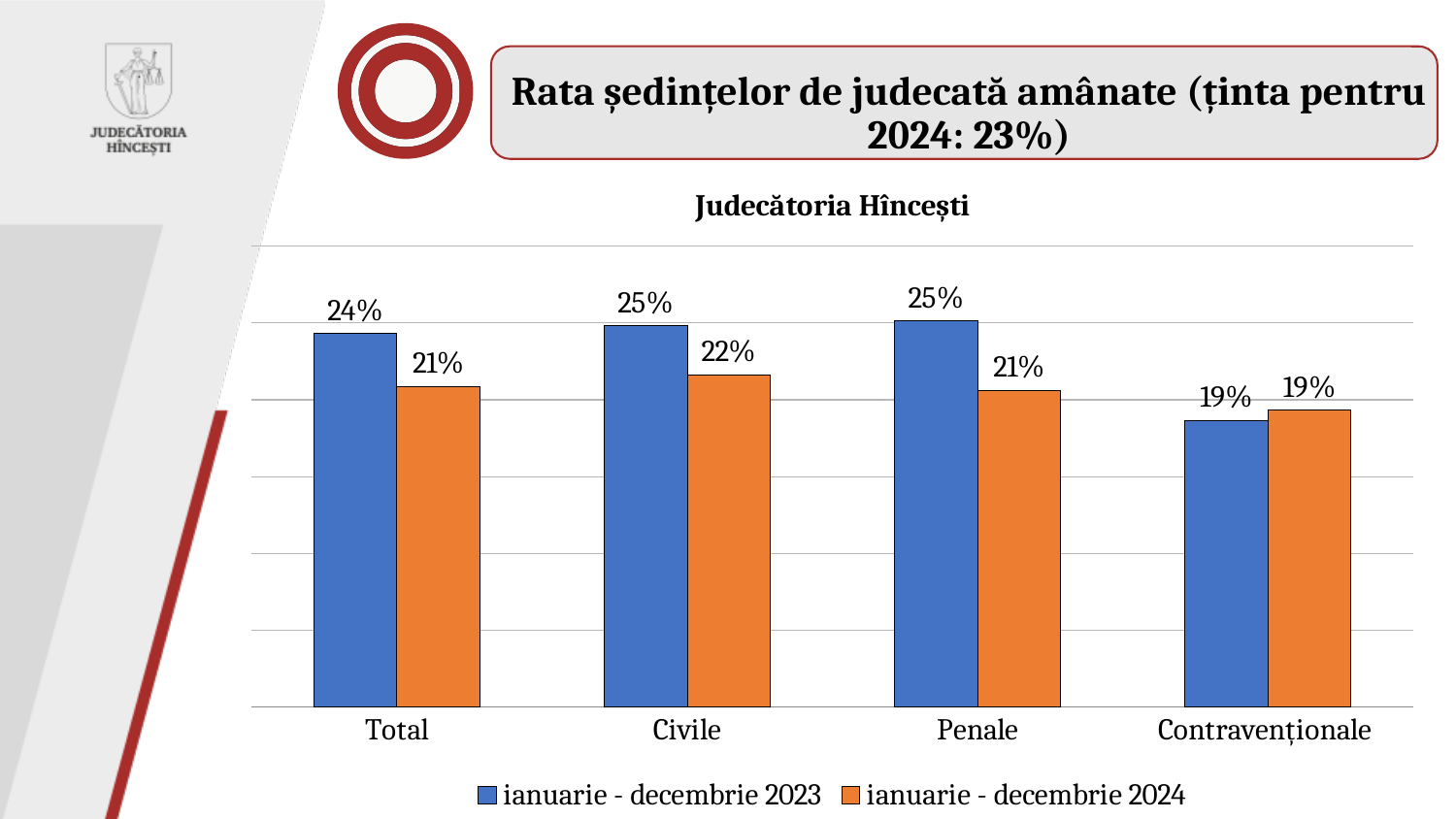
What is the value for Penale in the ianuarie - decembrie 2023 series? 25% What is the value for Civile in the ianuarie - decembrie 2024 series? 22% Which category has the highest value in the ianuarie - decembrie 2024 series? Civile What is the difference between the 2023 and 2024 values for Penale? 4% What kind of chart is shown on the slide? Bar chart What is the value for Total in the ianuarie - decembrie 2023 series? 24% Which category has the lowest value in the ianuarie - decembrie 2023 series? Contravenționale What is the difference between the 2023 and 2024 values for Total? 3% What is the value for Contravenționale in the ianuarie - decembrie 2024 series? 19% How many series does the legend list? 2 Which is larger for Civile: the ianuarie - decembrie 2023 value or the ianuarie - decembrie 2024 value? ianuarie - decembrie 2023 How many categories are shown on the x axis? 4